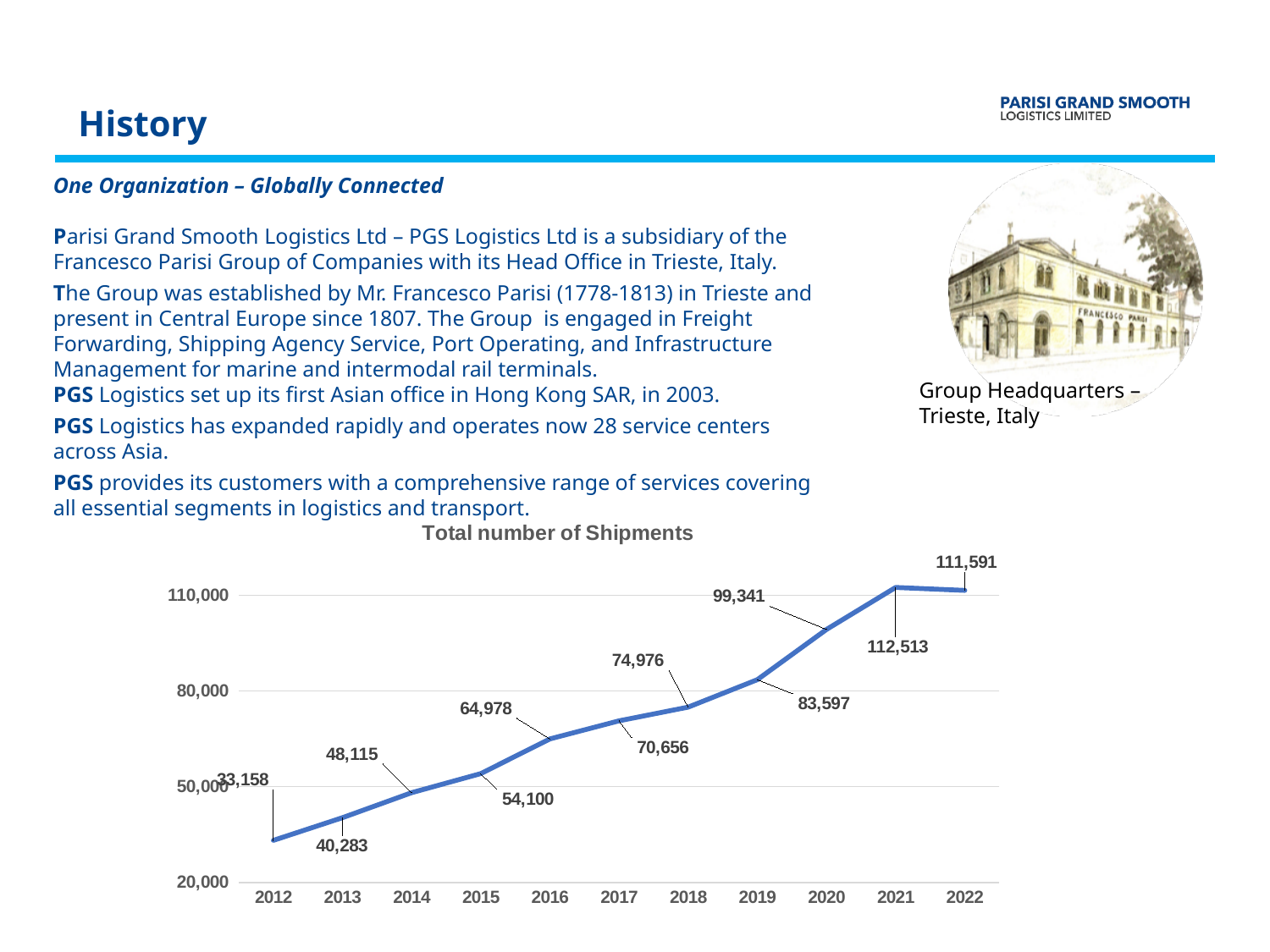
What is the difference in shipments between 2021 and 2022? 922 Which year had more shipments, 2018 or 2019? 2019 What was the total number of shipments in 2020? 99,341 What was the total number of shipments in 2016? 64,978 Do the shipment values generally rise or fall from 2012 to 2021? rise Which year had the lowest total number of shipments? 2012 How many years are plotted on the x axis? 11 What was the total number of shipments in 2022? 111,591 What kind of chart is shown on the slide? line chart What is the title of the chart? Total number of Shipments What was the total number of shipments in 2012? 33,158 Which year had the highest total number of shipments? 2021